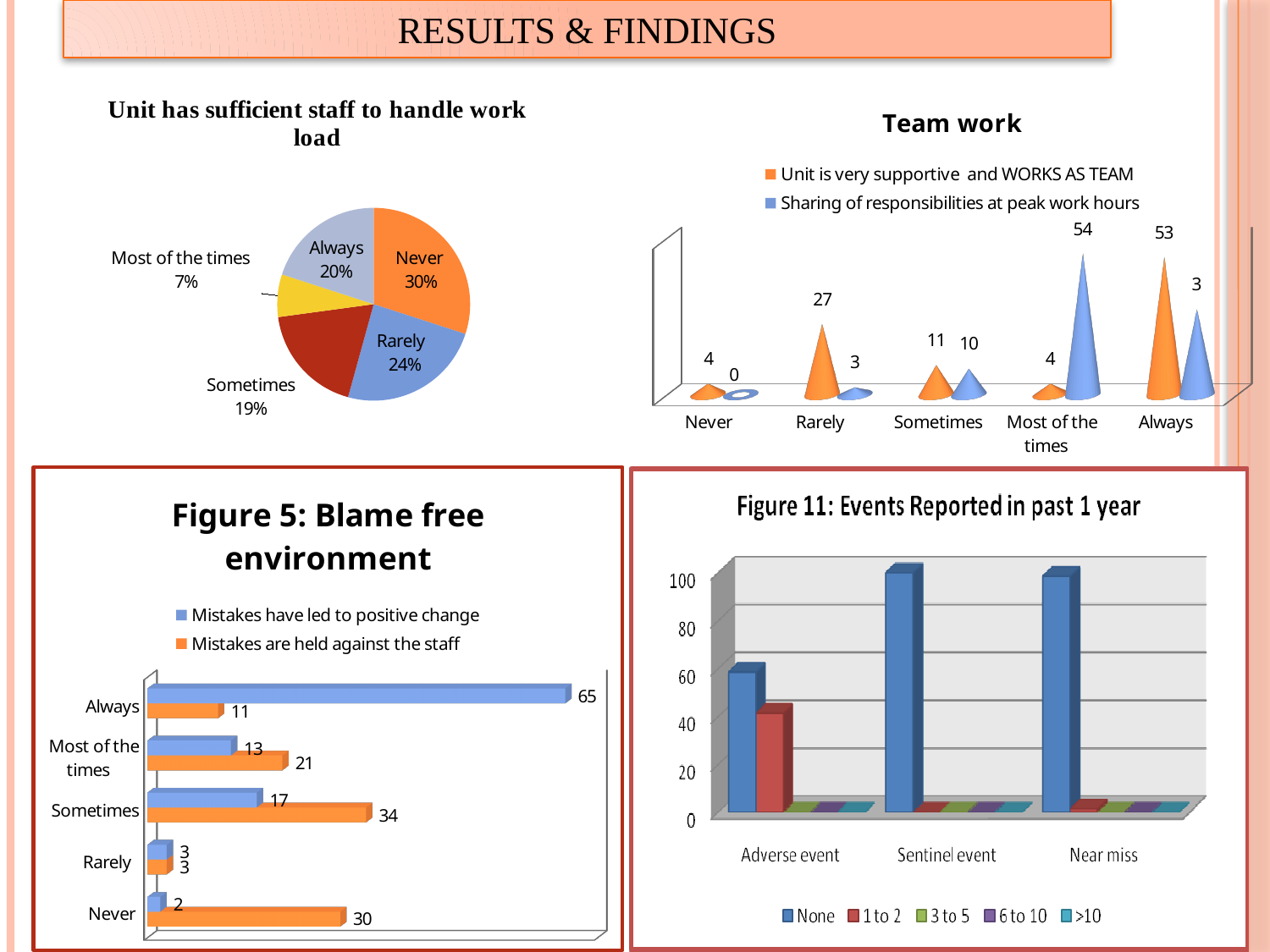
In 'Figure 11: Events Reported in past 1 year', how many series does the legend list? 5 In the pie chart 'Unit has sufficient staff to handle work load', which category has the smallest share? Most of the times In the pie chart 'Unit has sufficient staff to handle work load', how many slices are there? 5 What type of chart is 'Figure 5: Blame free environment'? Bar chart In 'Figure 5: Blame free environment', which is larger at Never: 'Mistakes have led to positive change' or 'Mistakes are held against the staff'? Mistakes are held against the staff In 'Figure 5: Blame free environment', what is the value for 'Mistakes are held against the staff' at Sometimes? 34 In the 'Team work' chart, what is the value for 'Unit is very supportive and WORKS AS TEAM' at Rarely? 27 In the 'Team work' chart, which category has the highest value for 'Unit is very supportive and WORKS AS TEAM'? Always In the pie chart 'Unit has sufficient staff to handle work load', what percentage is shown for Never? 30% In 'Figure 11: Events Reported in past 1 year', is the value for None at Adverse event greater or less than 40? greater In the 'Team work' chart, what is the value for 'Sharing of responsibilities at peak work hours' at Most of the times? 54